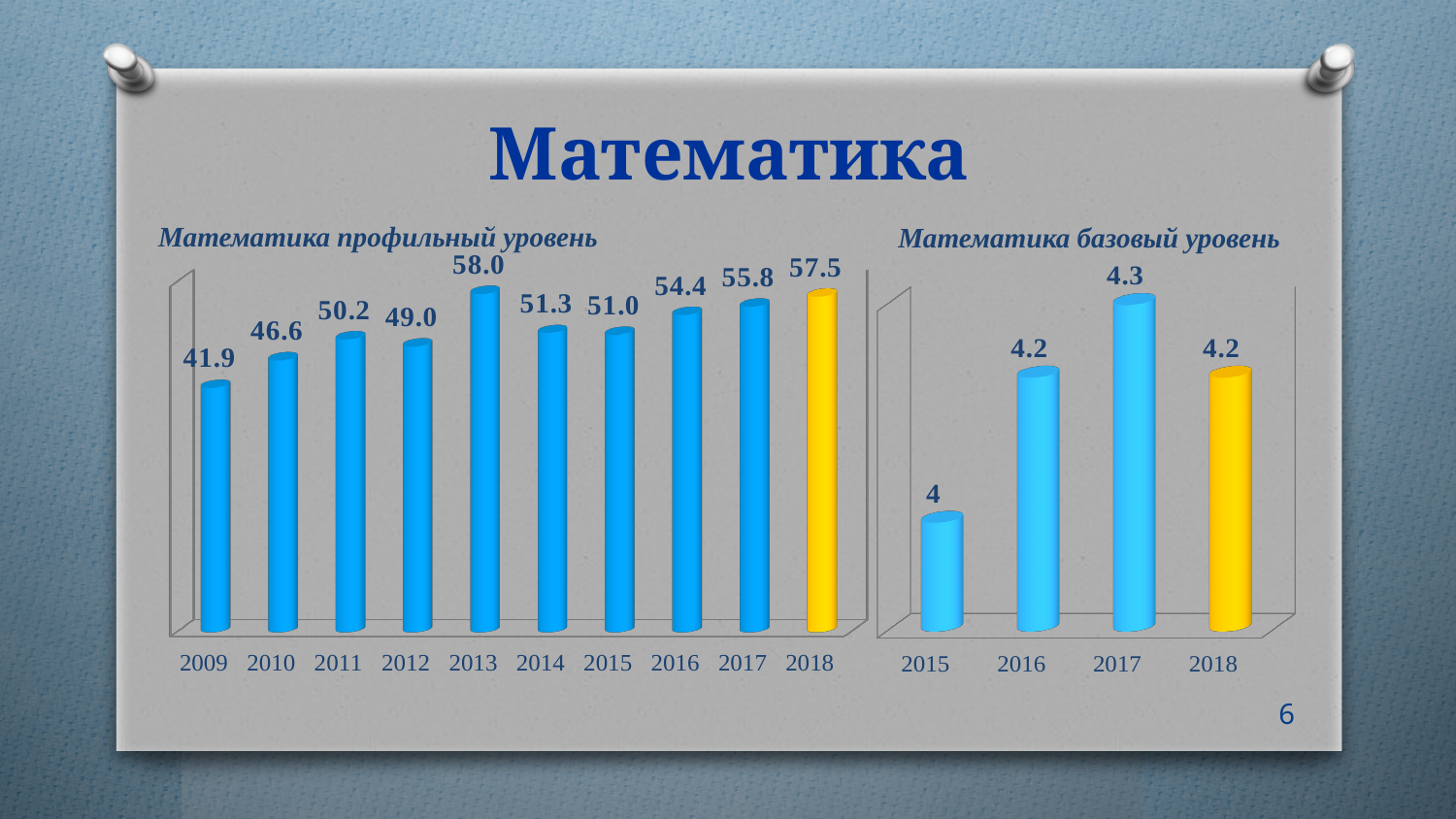
How many years are shown in the 'Математика профильный уровень' chart? 10 In the 'Математика базовый уровень' chart, what is the value for 2017? 4.3 What kind of chart is the 'Математика базовый уровень' chart? Bar chart In the 'Математика профильный уровень' chart, which is larger, the value for 2014 or the value for 2015? 2014 In the 'Математика базовый уровень' chart, which year has the lowest value? 2015 In the 'Математика профильный уровень' chart, what is the difference between the values for 2018 and 2017? 1.7 In the 'Математика профильный уровень' chart, what is the value for 2013? 58.0 In the 'Математика профильный уровень' chart, which year has the lowest value? 2009 In the 'Математика базовый уровень' chart, what is the value for 2015? 4 How many years are shown in the 'Математика базовый уровень' chart? 4 In the 'Математика профильный уровень' chart, which year has the highest value? 2013 In the 'Математика профильный уровень' chart, what is the value for 2009? 41.9